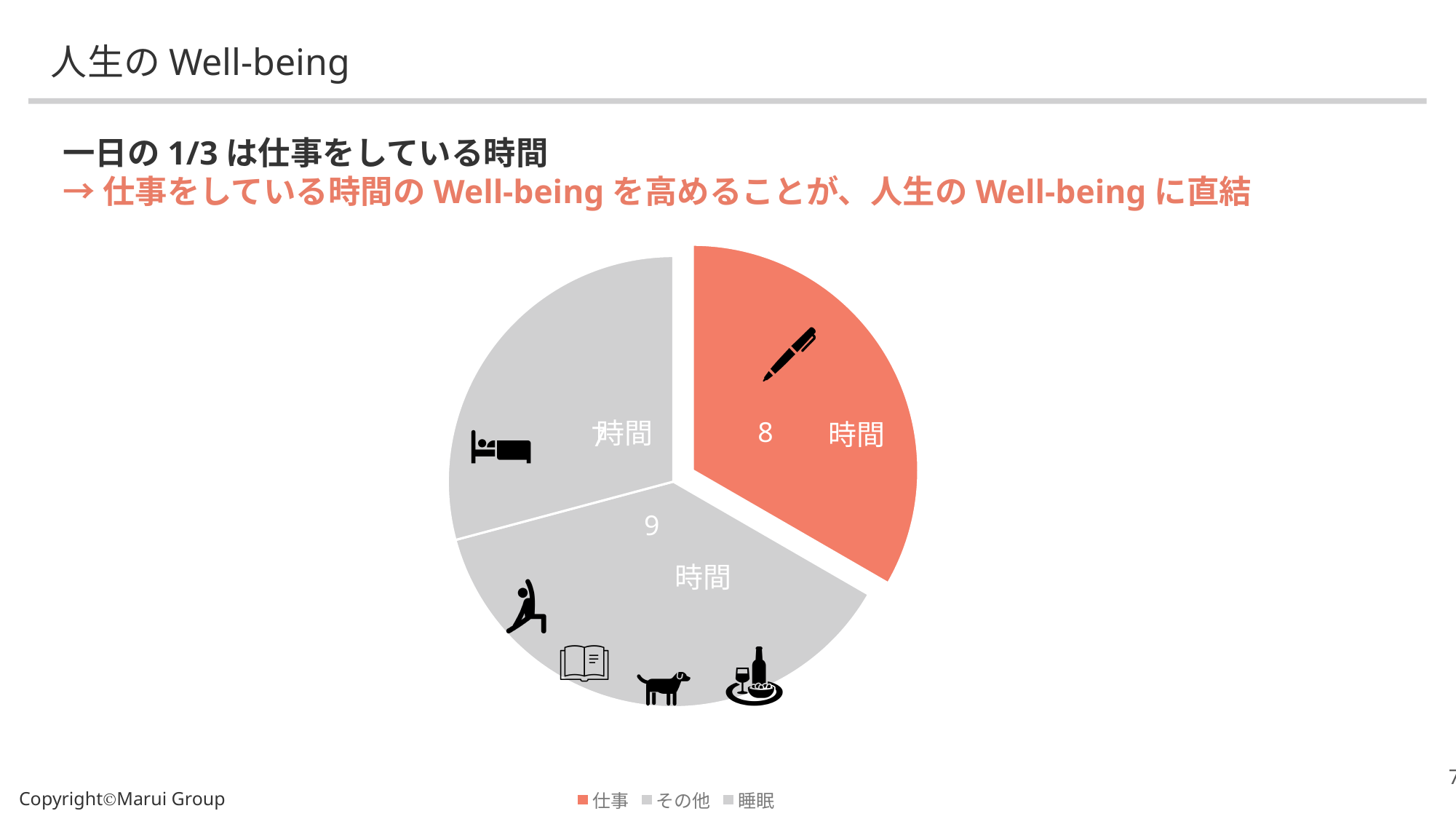
What value is shown for 仕事 in the pie chart? 8 時間 What is the difference between the values for その他 and 仕事 in the pie chart? 1 時間 What colour is the 仕事 slice in the pie chart? orange What kind of chart is shown on the slide? pie chart How many slices does the pie chart have? 3 How many categories does the legend of the pie chart list? 3 What value is shown for その他 in the pie chart? 9 時間 Which category has the largest slice in the pie chart? その他 Which is larger in the pie chart, 仕事 or その他? その他 What are the three legend entries of the pie chart? 仕事, その他, 睡眠